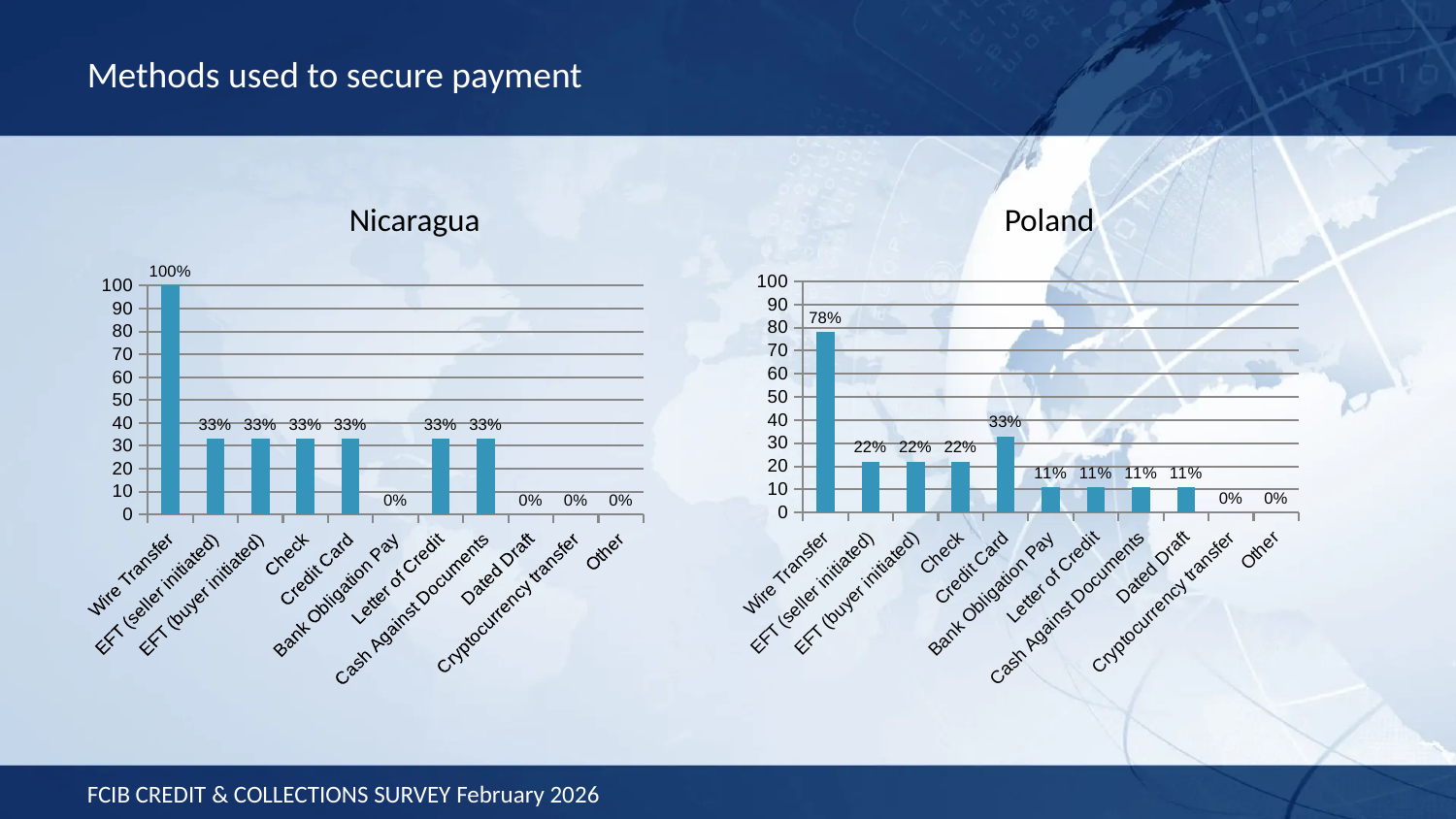
What type of chart is used for Nicaragua? Bar chart In the Nicaragua chart, what is the value for Wire Transfer? 100% How many categories are shown on the x axis of the Poland chart? 11 In the Nicaragua chart, what is the value for Bank Obligation Pay? 0% In the Poland chart, which category has the highest value? Wire Transfer In the Poland chart, what is the value for Credit Card? 33% In the Nicaragua chart, which category has the highest value? Wire Transfer In the Poland chart, what is the value for Wire Transfer? 78% In the Nicaragua chart, what is the difference between Wire Transfer and Check? 67% In the Poland chart, what is the difference between Wire Transfer and Credit Card? 45% In the Poland chart, what is the value for Letter of Credit? 11% Which chart shows a larger value for Wire Transfer, Nicaragua or Poland? Nicaragua